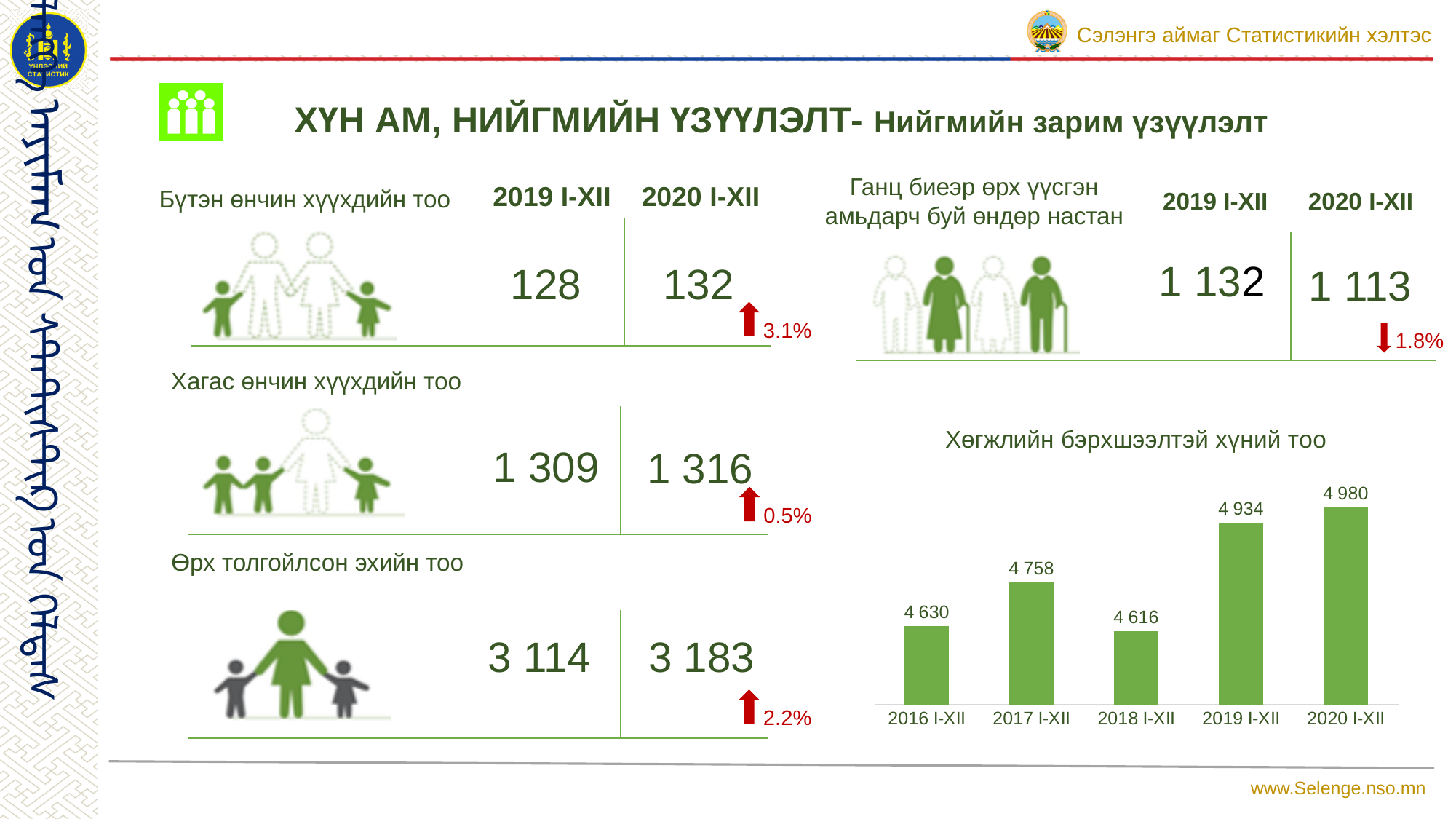
What is the value for 2016 I-XII in the 'Хөгжлийн бэрхшээлтэй хүний тоо' chart? 4 630 What is the value for 2018 I-XII in the 'Хөгжлийн бэрхшээлтэй хүний тоо' chart? 4 616 What is the title of the bar chart on the slide? Хөгжлийн бэрхшээлтэй хүний тоо In the 'Хөгжлийн бэрхшээлтэй хүний тоо' chart, what is the difference between the values for 2020 I-XII and 2019 I-XII? 46 What kind of chart is 'Хөгжлийн бэрхшээлтэй хүний тоо'? Bar chart Which period has the highest value in the 'Хөгжлийн бэрхшээлтэй хүний тоо' chart? 2020 I-XII How many bars are shown in the 'Хөгжлийн бэрхшээлтэй хүний тоо' chart? 5 Which period has the lowest value in the 'Хөгжлийн бэрхшээлтэй хүний тоо' chart? 2018 I-XII In the 'Хөгжлийн бэрхшээлтэй хүний тоо' chart, what is the difference between the values for 2017 I-XII and 2016 I-XII? 128 In the 'Хөгжлийн бэрхшээлтэй хүний тоо' chart, does the value rise or fall from 2018 I-XII to 2020 I-XII? Rise What is the value for 2020 I-XII in the 'Хөгжлийн бэрхшээлтэй хүний тоо' chart? 4 980 In the 'Хөгжлийн бэрхшээлтэй хүний тоо' chart, which is larger: the value for 2017 I-XII or 2018 I-XII? 2017 I-XII